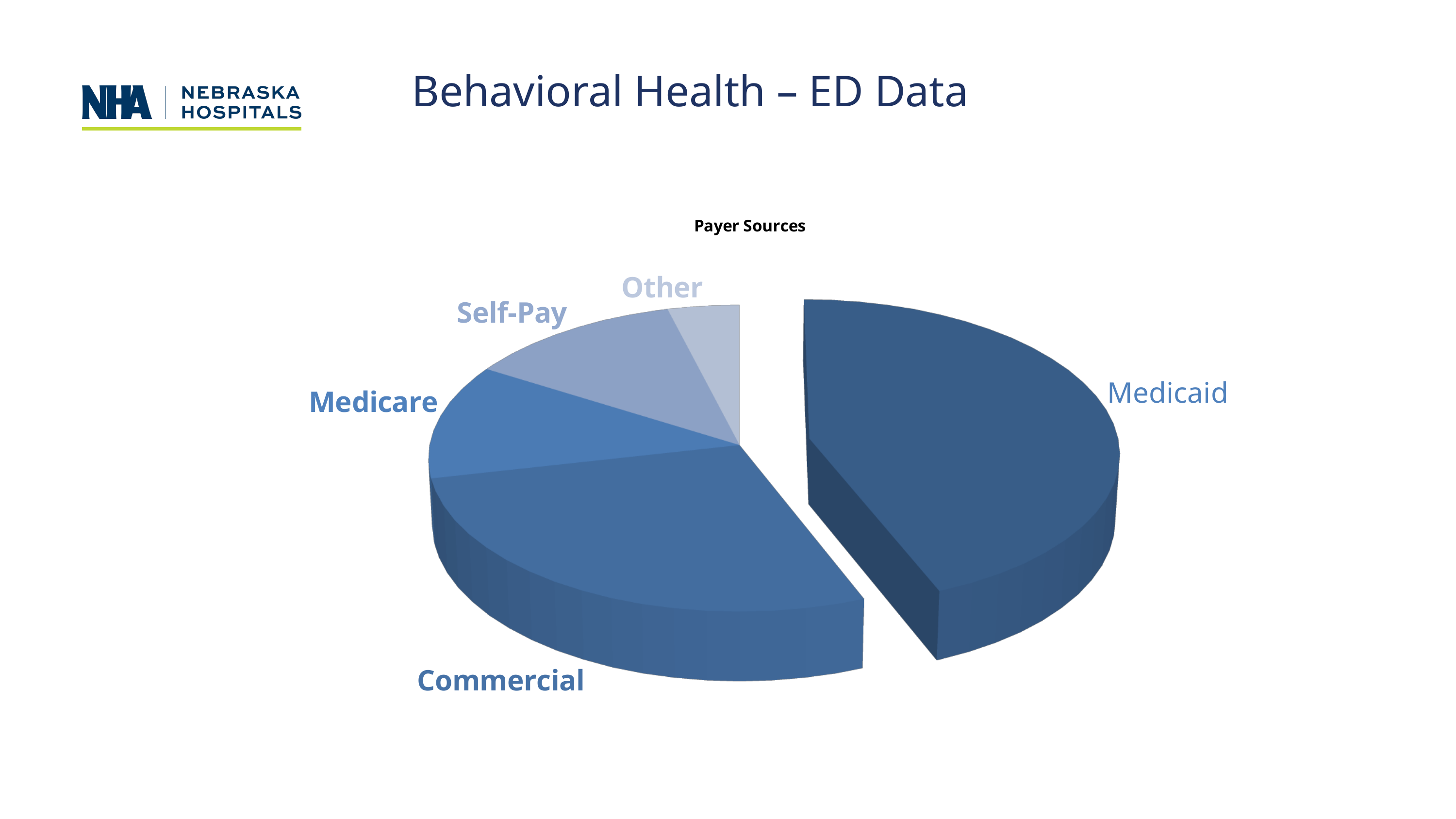
Which slice is larger, Commercial or Medicare? Commercial What is the title of the chart? Payer Sources How many payer source categories are shown in the pie chart? 5 Which slice is pulled out (exploded) from the rest of the pie? Medicaid Which payer source has the smallest slice of the pie? Other Which slice is larger, Self-Pay or Other? Self-Pay Which slice is larger, Commercial or Self-Pay? Commercial Which payer source has the largest slice of the pie? Medicaid What kind of chart is shown on the slide? Pie chart